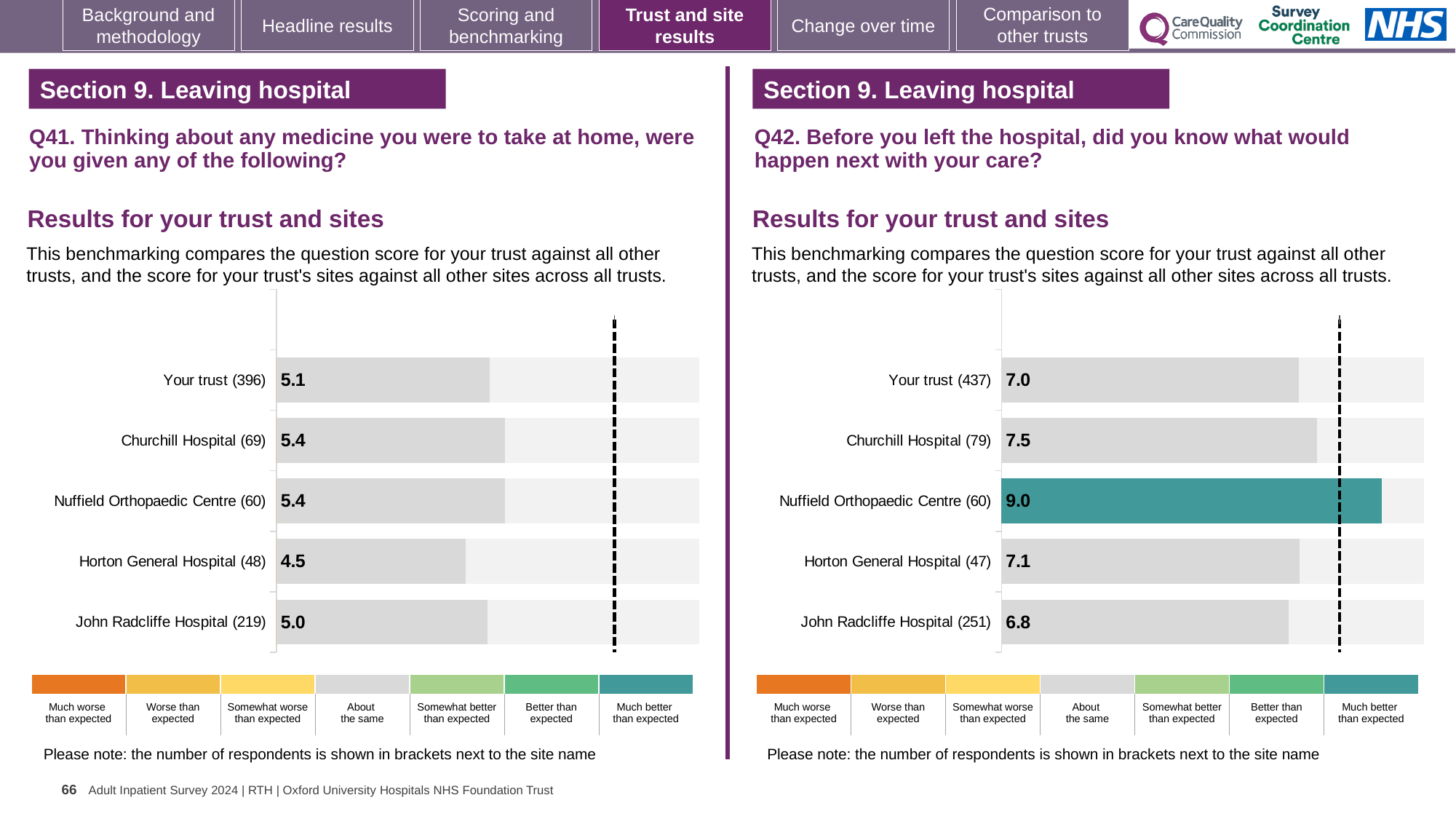
On the Q42 chart (right), which site's bar is coloured teal, indicating 'Much better than expected'? Nuffield Orthopaedic Centre On the Q41 chart (left), what is the score for Horton General Hospital? 4.5 On the Q41 chart (left), which site has the lowest score? Horton General Hospital On the Q42 chart (right), what is the difference between the scores for Nuffield Orthopaedic Centre and Your trust? 2.0 On the Q42 chart (right), which site has the highest score? Nuffield Orthopaedic Centre On the Q41 chart (left), what is the difference between the scores for Churchill Hospital and John Radcliffe Hospital? 0.4 On the Q42 chart (right), which has the higher score, Churchill Hospital or Horton General Hospital? Churchill Hospital On the Q42 chart (right), what is the score for Nuffield Orthopaedic Centre? 9.0 On the Q42 chart (right), which site has the lowest score? John Radcliffe Hospital On the Q41 chart (left), how many bars are plotted? 5 What kind of chart is used on the Q42 chart (right)? Bar chart On the Q41 chart (left), what is the score for Your trust? 5.1